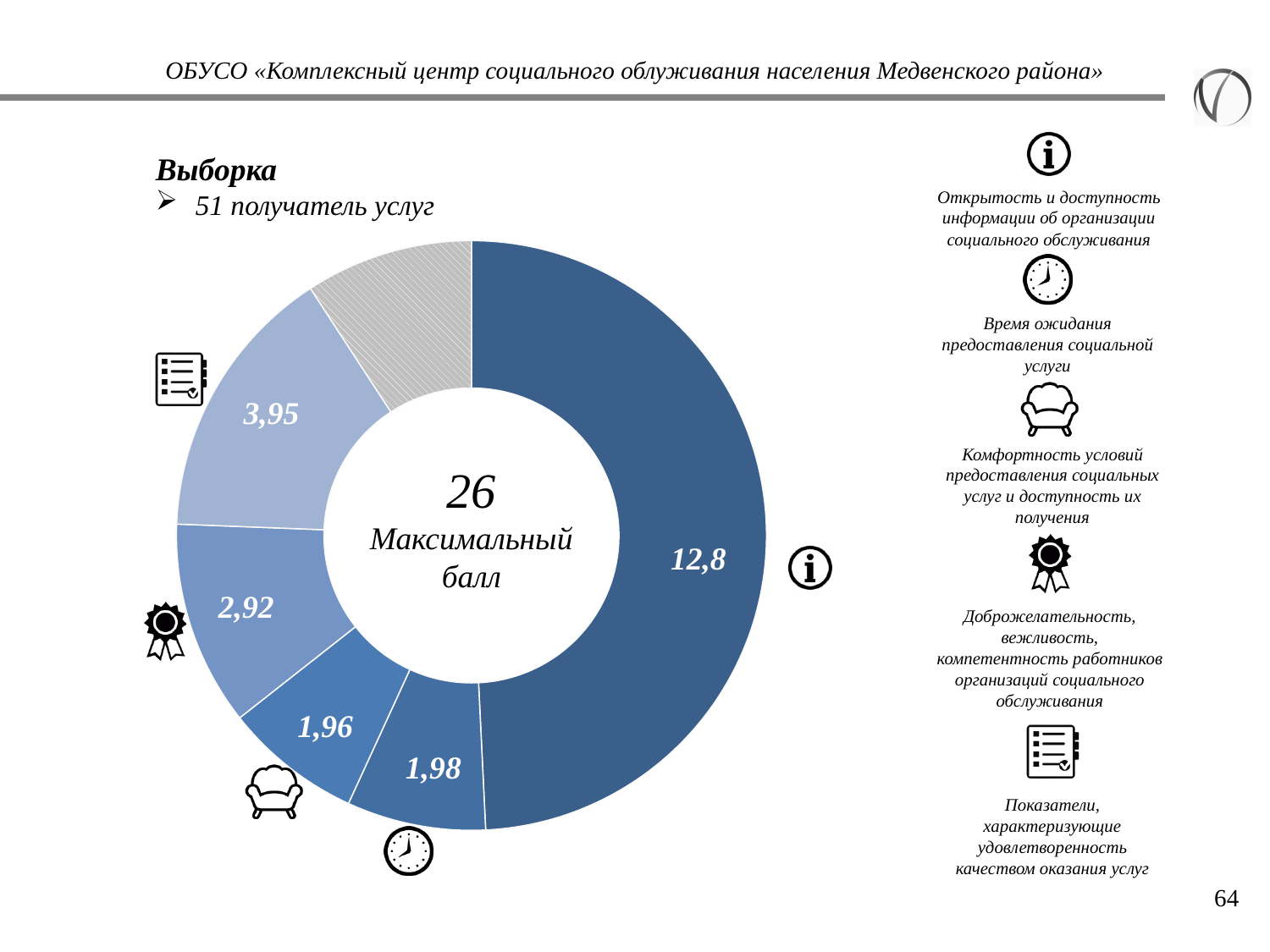
What value is shown for the segment marked with the clock icon (Время ожидания предоставления социальной услуги)? 1,98 What kind of chart is shown on the slide? Donut (pie) chart Which criterion has the highest value in the chart? Открытость и доступность информации об организации социального обслуживания (12,8) How many segments with printed value labels does the donut chart have? 5 Which is larger: the value for the award icon segment or the clock icon segment? The award icon segment (2,92) Which labelled segment has the lowest value in the chart? Комфортность условий предоставления социальных услуг (1,96) What is the difference between the value for the information icon segment (12,8) and the checklist icon segment (3,95)? 8,85 What value is shown for the segment marked with the checklist icon (Показатели, характеризующие удовлетворенность качеством оказания услуг)? 3,95 What value is shown for the segment marked with the award icon (Доброжелательность, вежливость, компетентность работников)? 2,92 What value is shown for the segment marked with the information icon (Открытость и доступность информации об организации социального обслуживания)? 12,8 What value is shown for the segment marked with the armchair icon (Комфортность условий предоставления социальных услуг)? 1,96 What maximum score (Максимальный балл) is shown in the centre of the donut chart? 26